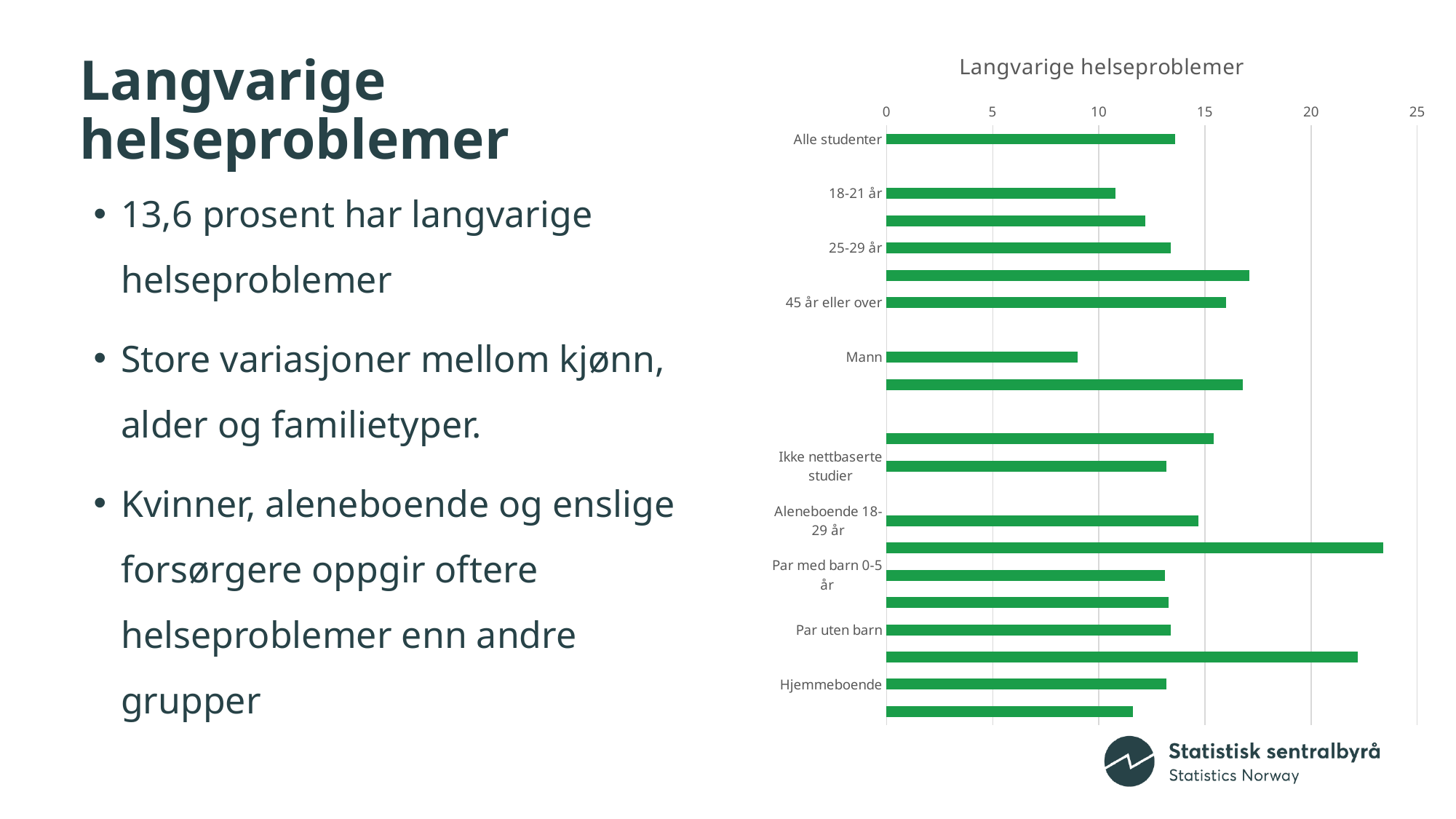
What kind of chart is shown on the slide? bar chart Which category has the lowest value in the chart? Mann Is the value for 45 år eller over greater or less than 15? greater Is the value for Hjemmeboende greater or less than 15? less Which is larger, the value for 18-21 år or the value for 25-29 år? 25-29 år Is the value for Alle studenter greater or less than 10? greater What is the title of the chart? Langvarige helseproblemer What is the highest value shown on the chart's horizontal axis? 25 Which is larger, the value for Mann or the value for 45 år eller over? 45 år eller over